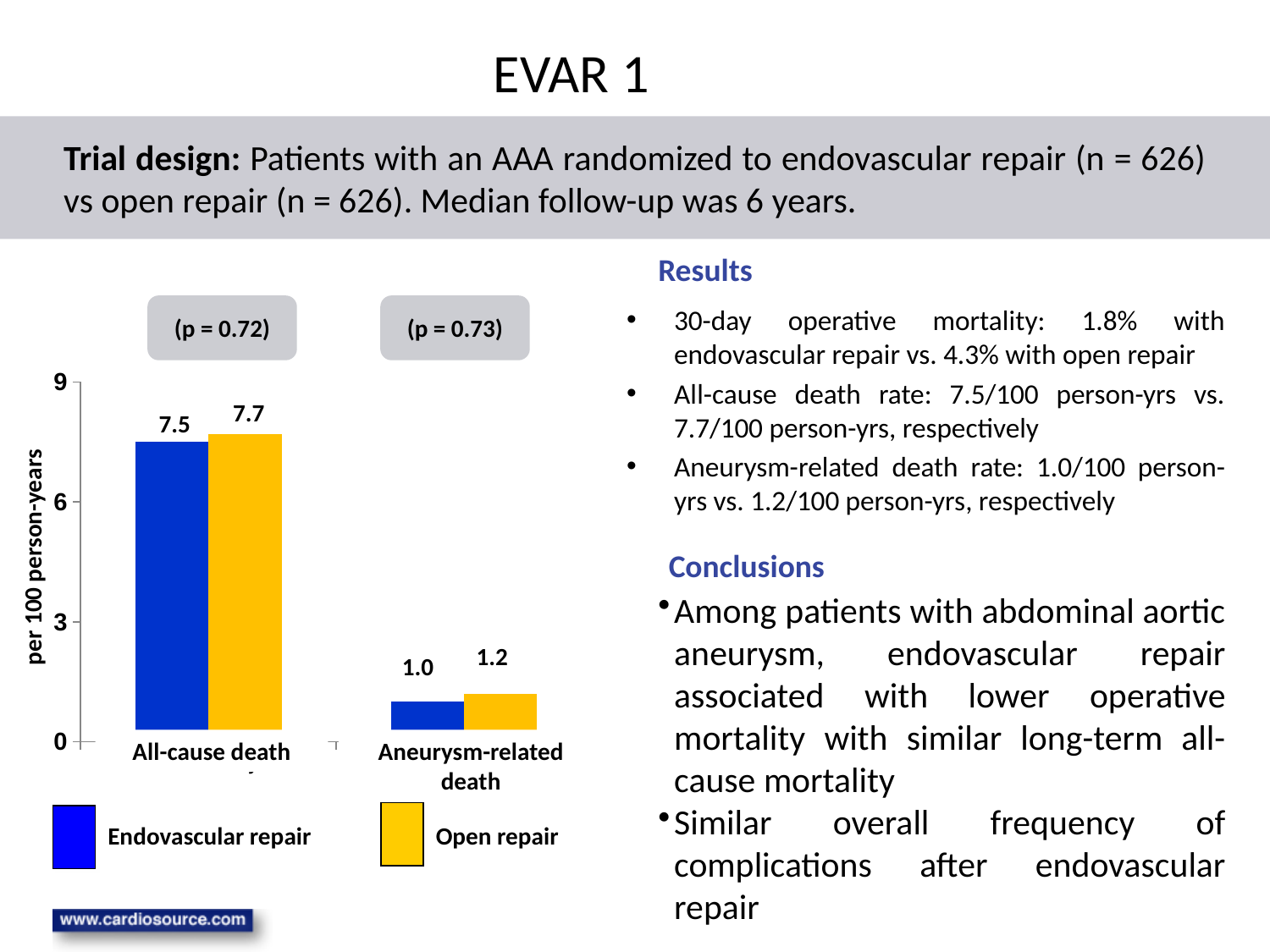
What is the all-cause death rate per 100 person-years for open repair? 7.7 Which is larger: the all-cause death rate for endovascular repair or for open repair? Open repair Which category has the highest value for open repair? All-cause death How many categories are shown on the x axis of the chart? 2 What is the p-value shown above the aneurysm-related death bars? p = 0.73 What is the difference between the open repair and endovascular repair values for all-cause death? 0.2 How many series does the legend list? 2 What is the aneurysm-related death rate per 100 person-years for open repair? 1.2 What is the all-cause death rate per 100 person-years for endovascular repair? 7.5 What is the aneurysm-related death rate per 100 person-years for endovascular repair? 1.0 Which category has the lowest value for endovascular repair? Aneurysm-related death What kind of chart is shown on the slide? Bar chart